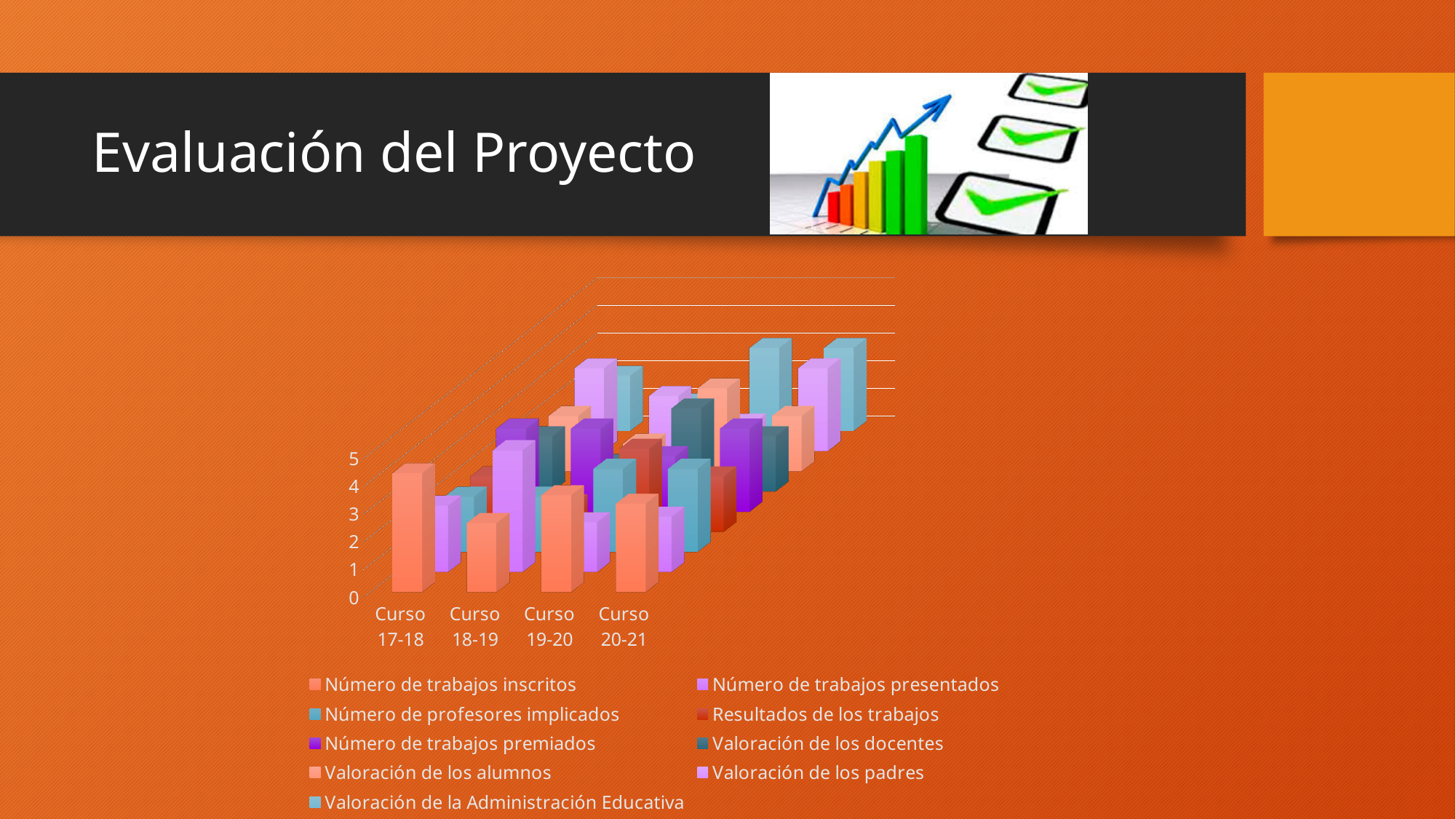
What is the label of the first category on the x axis? Curso 17-18 Is the value for Número de trabajos inscritos in Curso 17-18 greater or less than 2? greater How many categories (cursos) are shown on the x axis of the chart? 4 Is the value for Número de trabajos inscritos in Curso 19-20 greater or less than 1? greater Is the value for Número de trabajos inscritos in Curso 20-21 greater or less than 1? greater What is the label of the last category on the x axis? Curso 20-21 What kind of chart is shown on the slide? bar chart How many series does the chart's legend list? 9